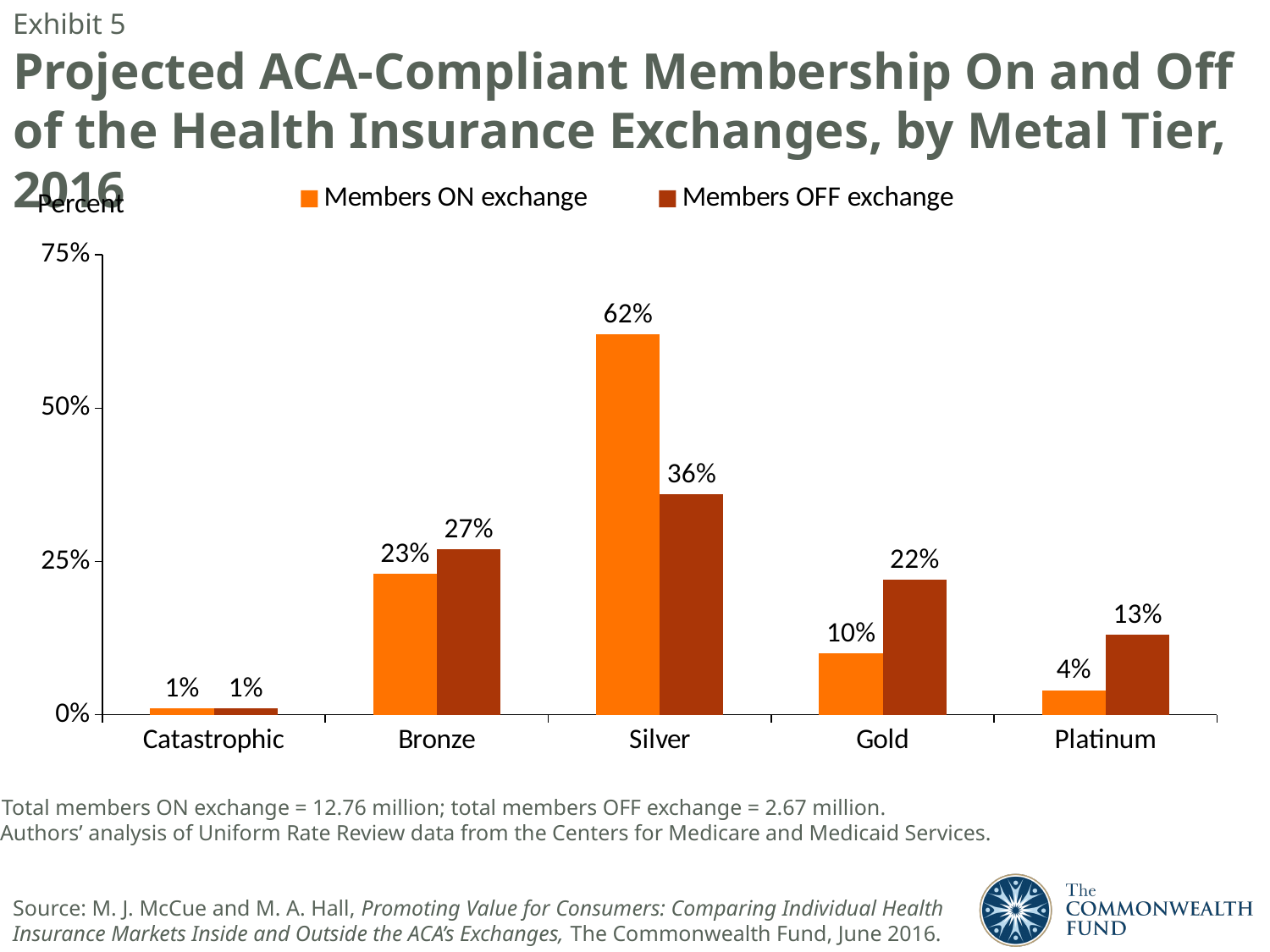
How many series does the legend list? 2 What kind of chart is shown on the slide? Bar chart What is the difference between Members OFF exchange and Members ON exchange in the Platinum tier? 9% Is the value for Members ON exchange in the Silver tier greater or less than 50%? greater Which metal tier has the highest value for Members OFF exchange? Silver Which is larger in the Bronze tier: Members ON exchange or Members OFF exchange? Members OFF exchange How many metal tiers are shown on the x axis? 5 What is the value for Members ON exchange in the Platinum tier? 4% Which metal tier has the lowest value for Members ON exchange? Catastrophic What is the value for Members OFF exchange in the Gold tier? 22% What is the difference between Members ON exchange and Members OFF exchange in the Silver tier? 26% What is the value for Members ON exchange in the Silver tier? 62%